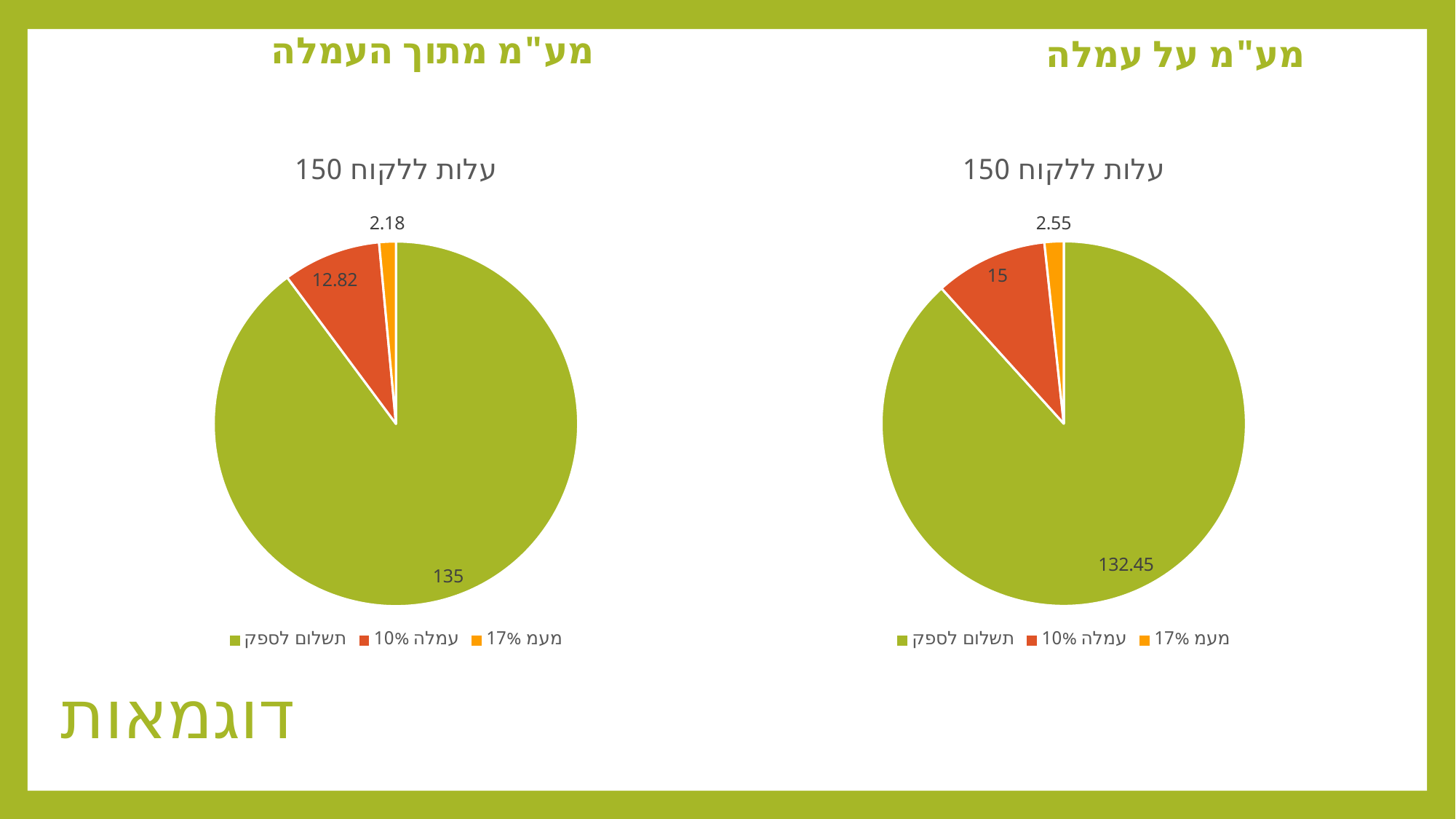
In the left pie chart (under the heading מע"מ מתוך העמלה), what is the value for תשלום לספק? 135 In the left pie chart (under the heading מע"מ מתוך העמלה), what is the value for עמלה 10%? 12.82 What type of chart is shown on the left side of the slide? pie chart In the right pie chart (under the heading מע"מ על עמלה), what is the value for עמלה 10%? 15 How many entries does the legend of the right pie chart list? 3 In the right pie chart (under the heading מע"מ על עמלה), what is the value for מעם 17%? 2.55 In the left pie chart (under the heading מע"מ מתוך העמלה), what is the value for מעם 17%? 2.18 In the right pie chart (under the heading מע"מ על עמלה), what is the value for תשלום לספק? 132.45 In the right pie chart (under the heading מע"מ על עמלה), what is the difference between the values for עמלה 10% and מעם 17%? 12.45 In the left pie chart (under the heading מע"מ מתוך העמלה), which category has the smallest slice? מעם 17% In the right pie chart (under the heading מע"מ על עמלה), which category has the largest slice? תשלום לספק Which is larger: the value for עמלה 10% in the left pie chart or the value for עמלה 10% in the right pie chart? the right pie chart (15)